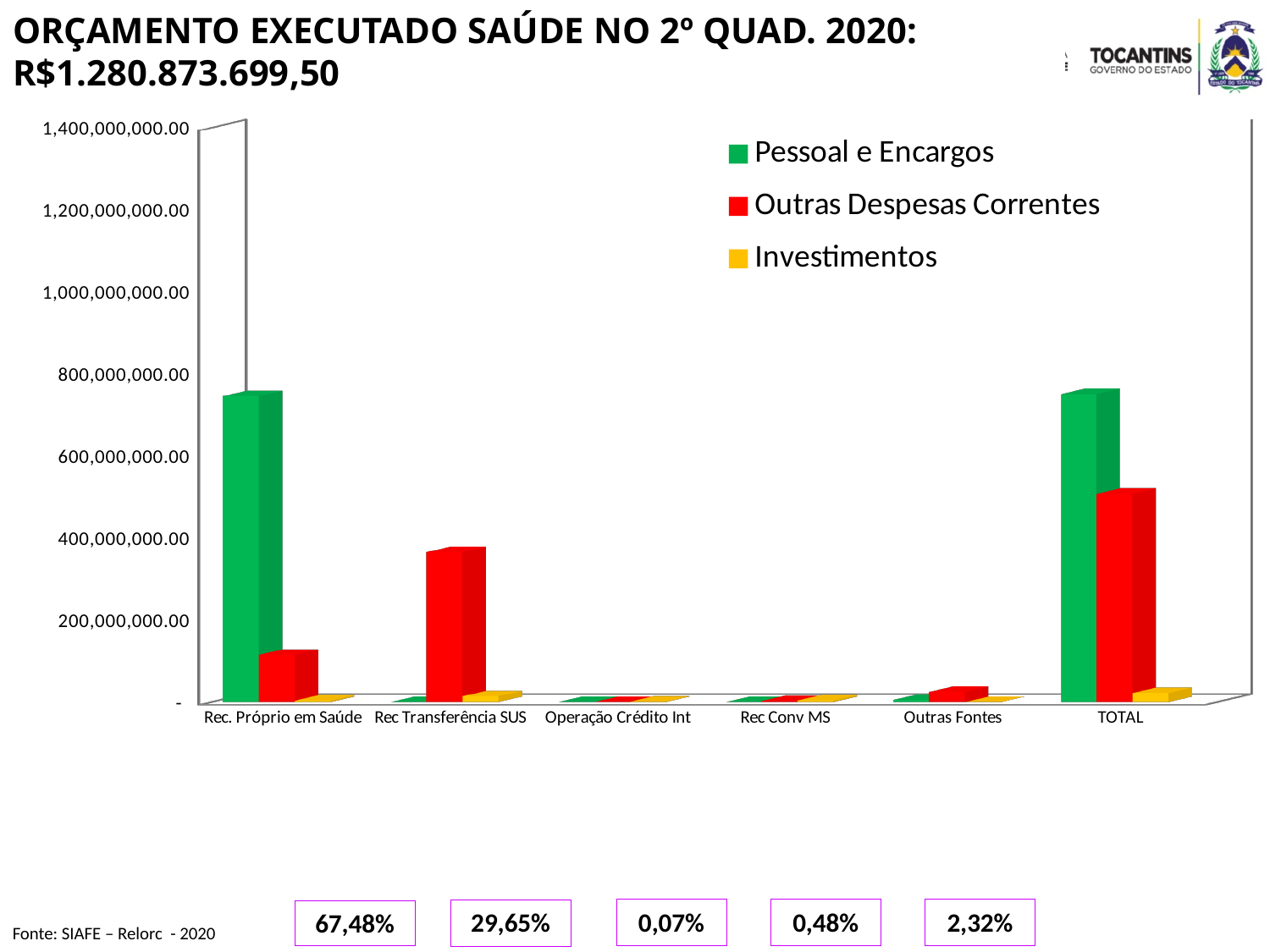
Is the value of Outras Despesas Correntes for Rec Transferência SUS greater or less than 400,000,000.00? less How many series does the legend list? 3 How many categories are shown along the x axis? 6 Which category has the highest value for Outras Despesas Correntes? TOTAL For Rec Transferência SUS, which is larger: Pessoal e Encargos or Outras Despesas Correntes? Outras Despesas Correntes What kind of chart is shown on the slide? bar chart Is the value of Outras Despesas Correntes for TOTAL greater or less than 400,000,000.00? greater Which colour represents Investimentos in the legend? yellow For Rec. Próprio em Saúde, which is larger: Pessoal e Encargos or Outras Despesas Correntes? Pessoal e Encargos Is the value of Outras Despesas Correntes for Rec. Próprio em Saúde greater or less than 200,000,000.00? less